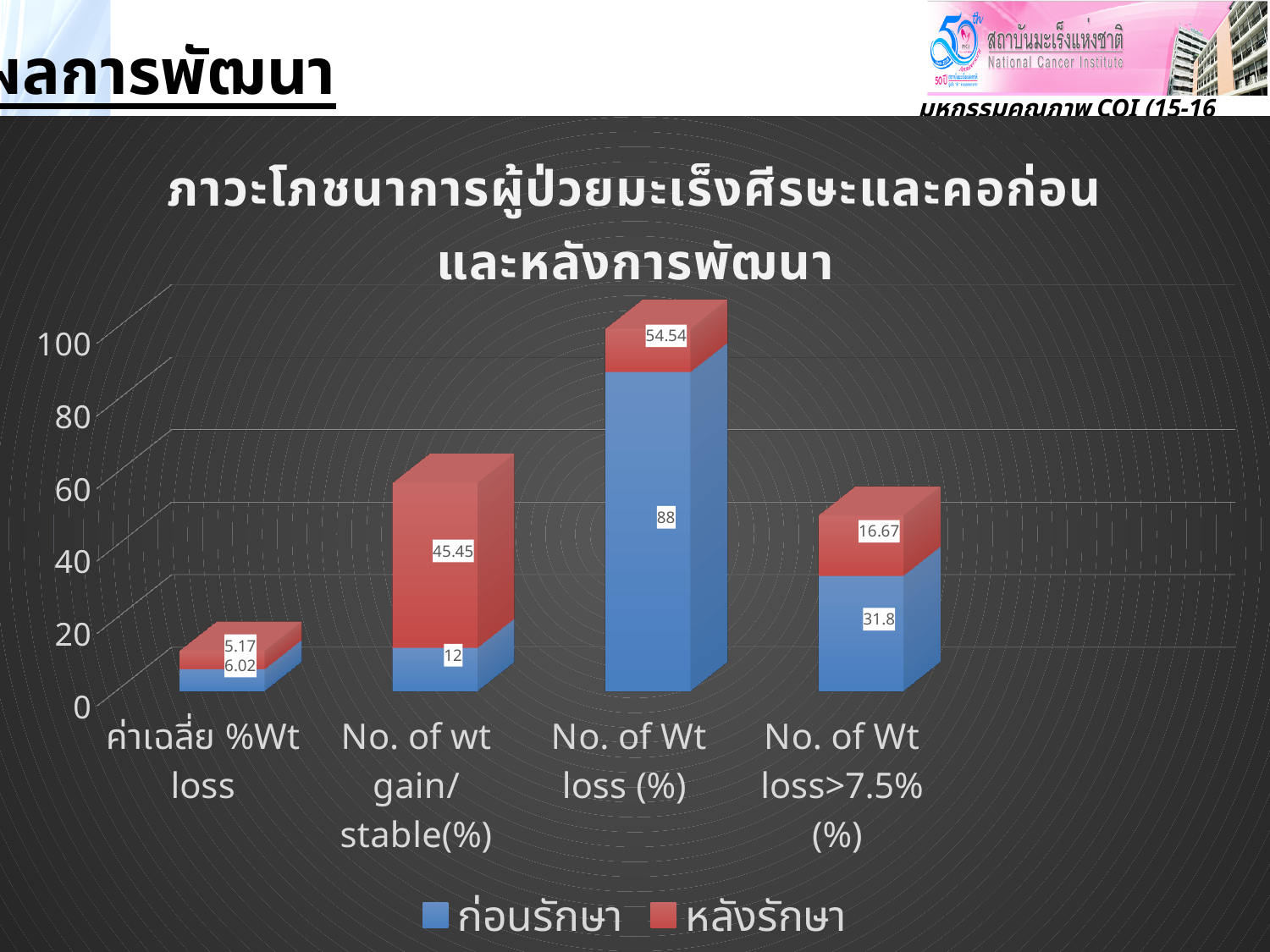
For No. of wt gain/stable(%), which series has the larger value, ก่อนรักษา or หลังรักษา? หลังรักษา What kind of chart is shown on the slide? Stacked bar chart What is the value of ก่อนรักษา for ค่าเฉลี่ย %Wt loss? 6.02 What is the value of หลังรักษา for No. of Wt loss>7.5% (%)? 16.67 What is the value of หลังรักษา for No. of wt gain/stable(%)? 45.45 What is the value of ก่อนรักษา for No. of Wt loss (%)? 88 What is the difference between the ก่อนรักษา and หลังรักษา values for No. of Wt loss (%)? 33.46 Which category has the highest ก่อนรักษา value? No. of Wt loss (%) What is the total of the stacked bar for No. of Wt loss>7.5% (%)? 48.47 Which category has the lowest หลังรักษา value? ค่าเฉลี่ย %Wt loss How many categories are shown on the x axis? 4 How many series does the legend list? 2